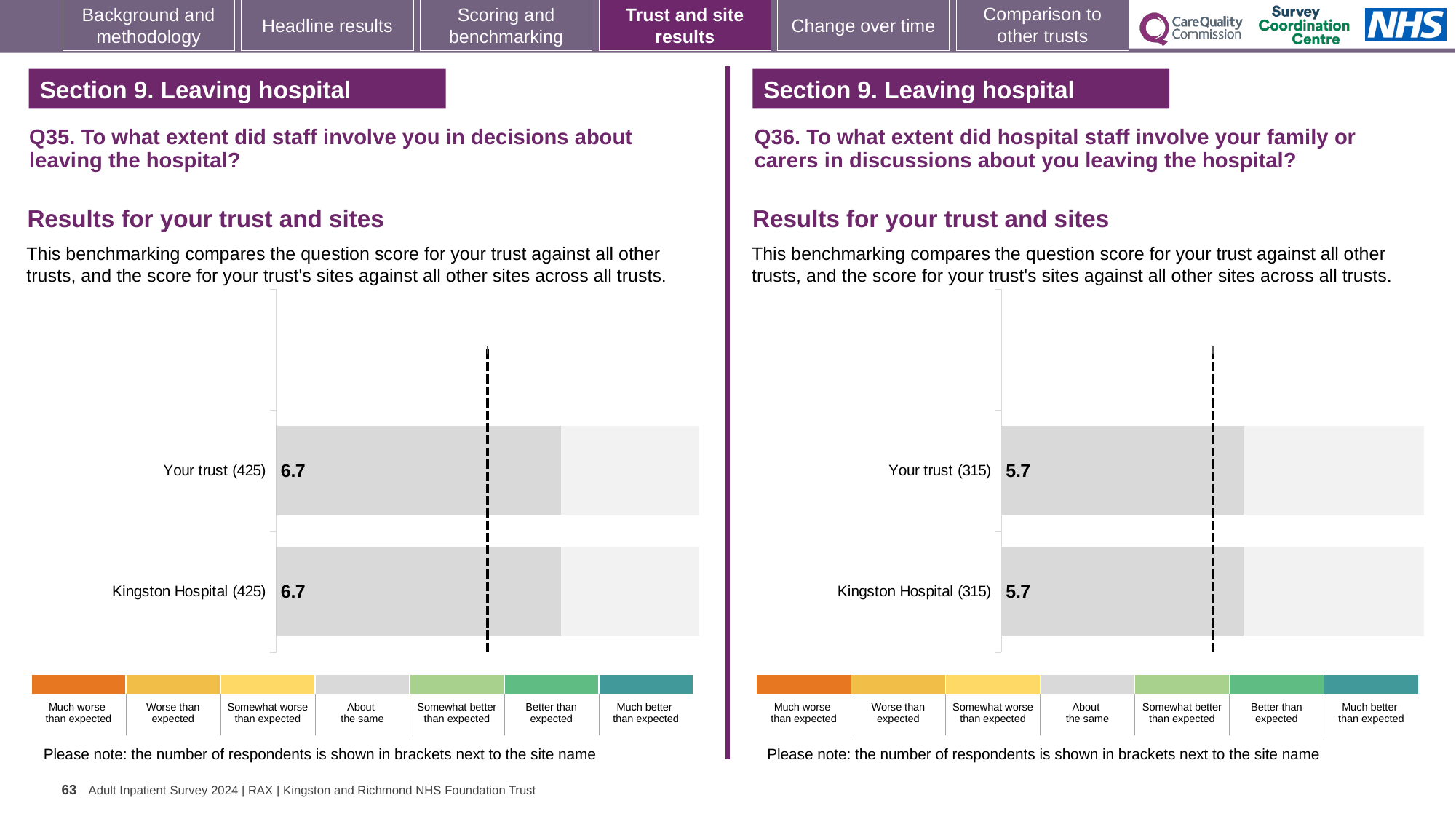
In the Q36 chart on the right, is the value for Your trust larger than, smaller than, or the same as the value for Kingston Hospital? the same In the Q35 chart on the left, what is the difference between the values for Your trust and Kingston Hospital? 0 How many bars are plotted in the Q36 chart on the right? 2 What is the difference between the Your trust value in the Q35 chart on the left and the Your trust value in the Q36 chart on the right? 1.0 In the Q35 chart on the left, how many respondents are shown in brackets next to Your trust? 425 In the Q36 chart on the right, what is the value for Your trust? 5.7 In the Q35 chart on the left, what is the value for Kingston Hospital? 6.7 In the Q35 chart on the left, what is the value for Your trust? 6.7 What kind of chart is used for the Q35 results on the left? Bar chart How many bars are plotted in the Q35 chart on the left? 2 In the Q36 chart on the right, what is the value for Kingston Hospital? 5.7 In the Q36 chart on the right, how many respondents are shown in brackets next to Kingston Hospital? 315